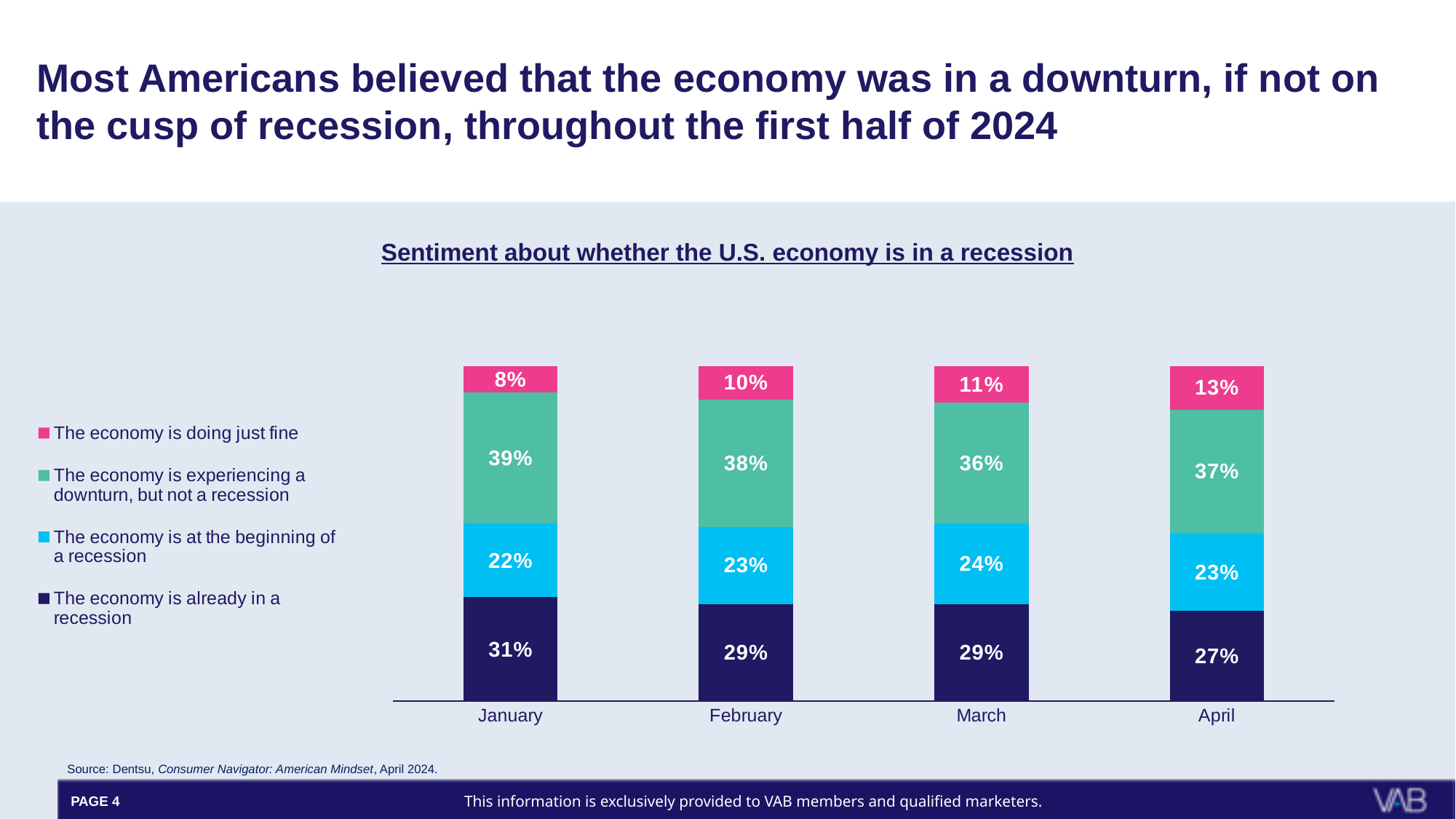
In which month was the share saying the economy is already in a recession lowest? April Does the share saying the economy is doing just fine rise or fall from January to April? Rise How many months are shown on the x axis? 4 What percentage said the economy is experiencing a downturn, but not a recession in March? 36% Which is larger: the 'doing just fine' share in January or in March? March How many series does the legend list? 4 What percentage said the economy is already in a recession in January? 31% What kind of chart is shown on the slide? Stacked bar chart What percentage said the economy is at the beginning of a recession in February? 23% What percentage said the economy is doing just fine in April? 13% What is the difference between the January and April values for 'The economy is already in a recession'? 4% In which month was the share saying the economy is doing just fine highest? April